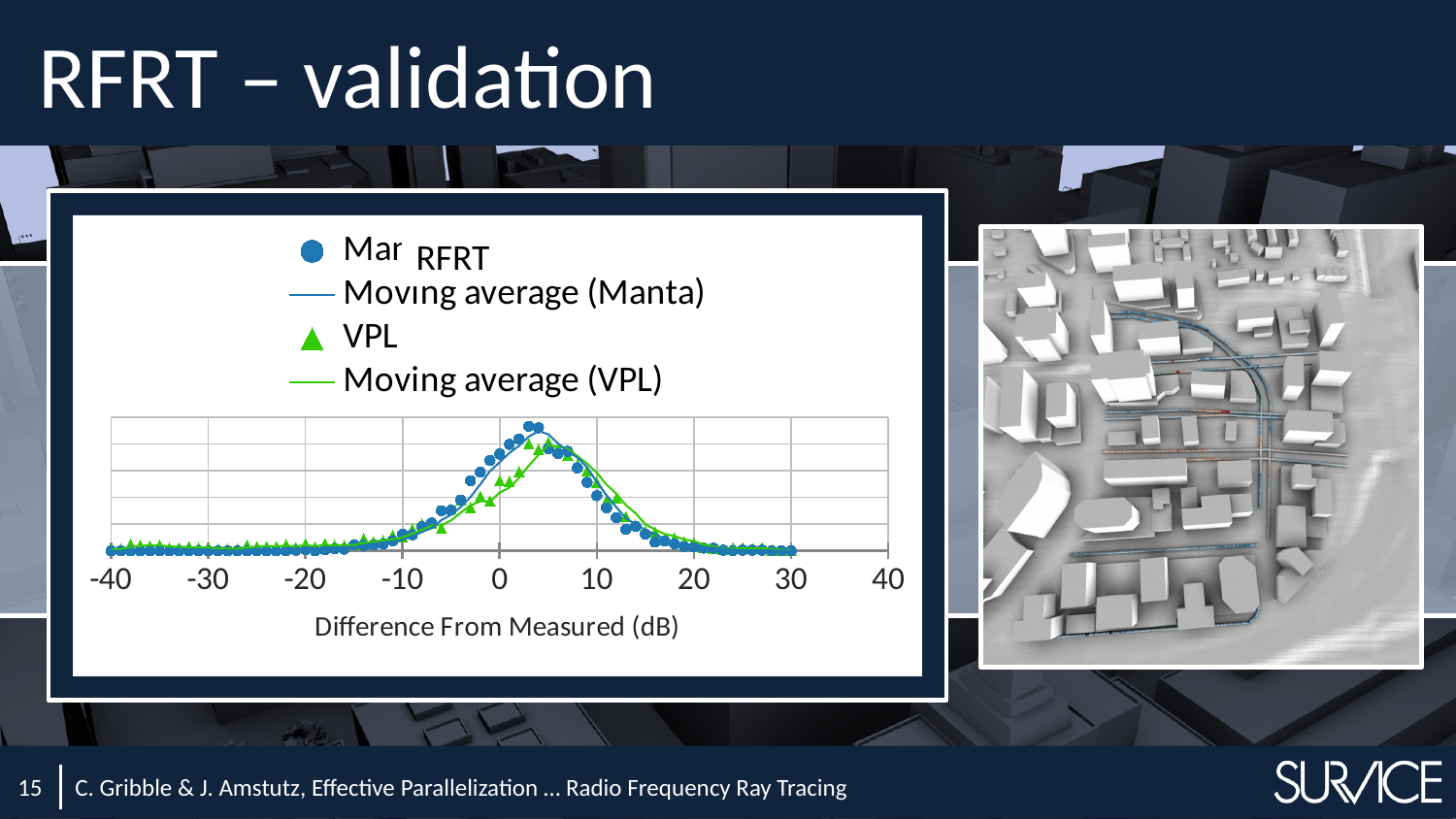
How many tick labels are shown on the chart's x axis? 9 Which series reaches a higher peak in the chart, the blue circles (RFRT) or the green triangles (VPL)? RFRT (blue circles) What kind of chart is shown on the slide? scatter chart What is the title of the chart's x axis? Difference From Measured (dB) Which series in the chart is plotted with green triangles? VPL Do the plotted values rise or fall as the x axis goes from -10 to 0? rise Is the x value at which the blue series peaks greater or less than 0? greater Do the plotted values rise or fall as the x axis goes from 0 to 20? fall How many series does the chart's legend list? 4